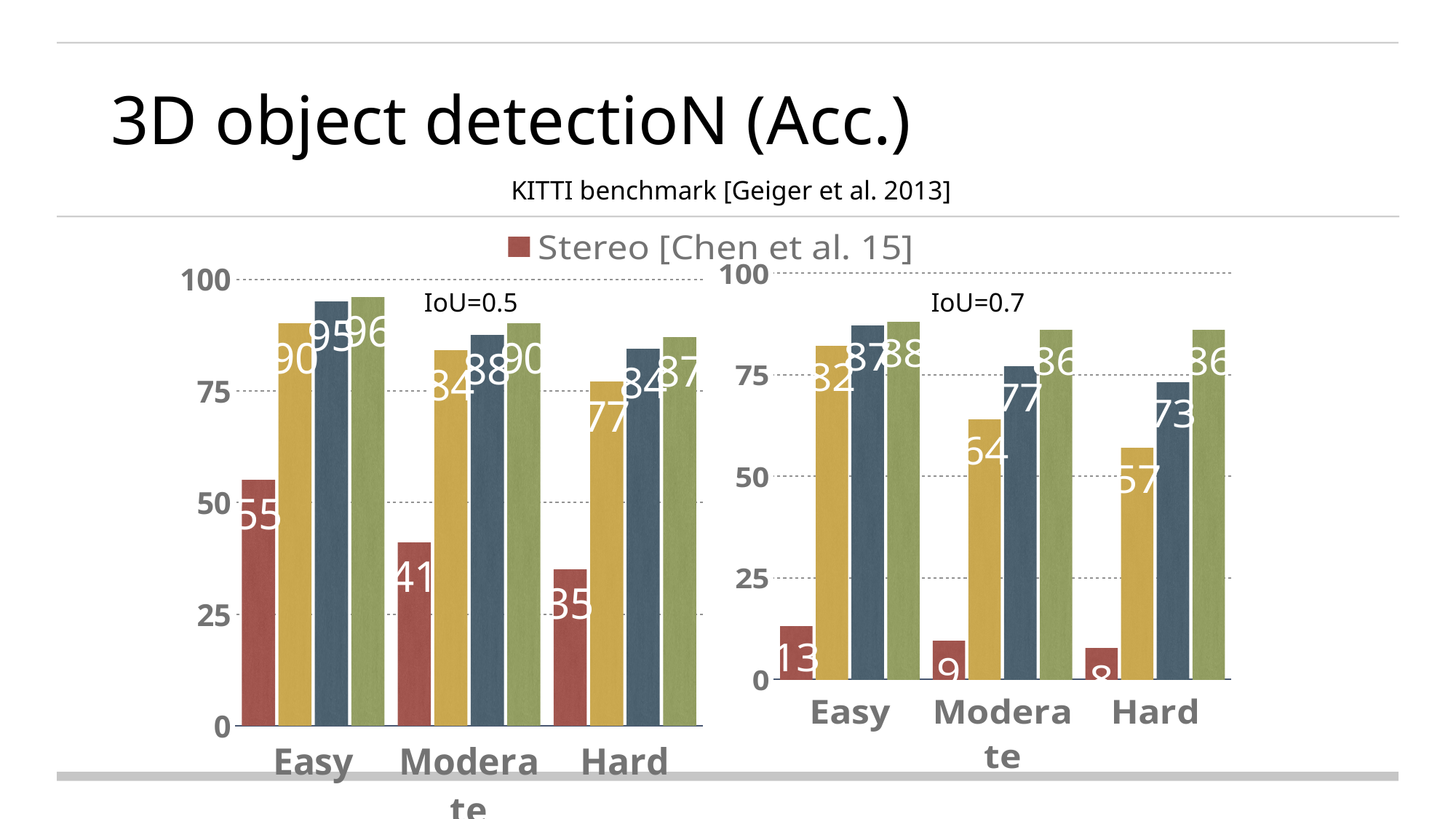
In the IoU=0.5 chart, what is the difference between the Stereo [Chen et al. 15] values for Easy and Hard? 20 Which series is named in the legend above the charts? Stereo [Chen et al. 15] In the IoU=0.7 chart, what is the value of Stereo [Chen et al. 15] for Hard? 8 What kind of chart is the IoU=0.7 chart? bar chart In the IoU=0.5 chart, do the Stereo [Chen et al. 15] values rise or fall from Easy to Hard? fall In the IoU=0.7 chart, what is the difference between the Stereo [Chen et al. 15] values for Easy and Moderate? 4 How many categories are shown on the x axis of the IoU=0.5 chart? 3 In the IoU=0.5 chart, what is the value of Stereo [Chen et al. 15] for Easy? 55 In the IoU=0.7 chart, what is the value of Stereo [Chen et al. 15] for Moderate? 9 In the IoU=0.5 chart, what is the value of Stereo [Chen et al. 15] for Moderate? 41 In the IoU=0.7 chart, which category has the highest Stereo [Chen et al. 15] value? Easy Is the Stereo [Chen et al. 15] value for Easy larger in the IoU=0.5 chart or the IoU=0.7 chart? IoU=0.5